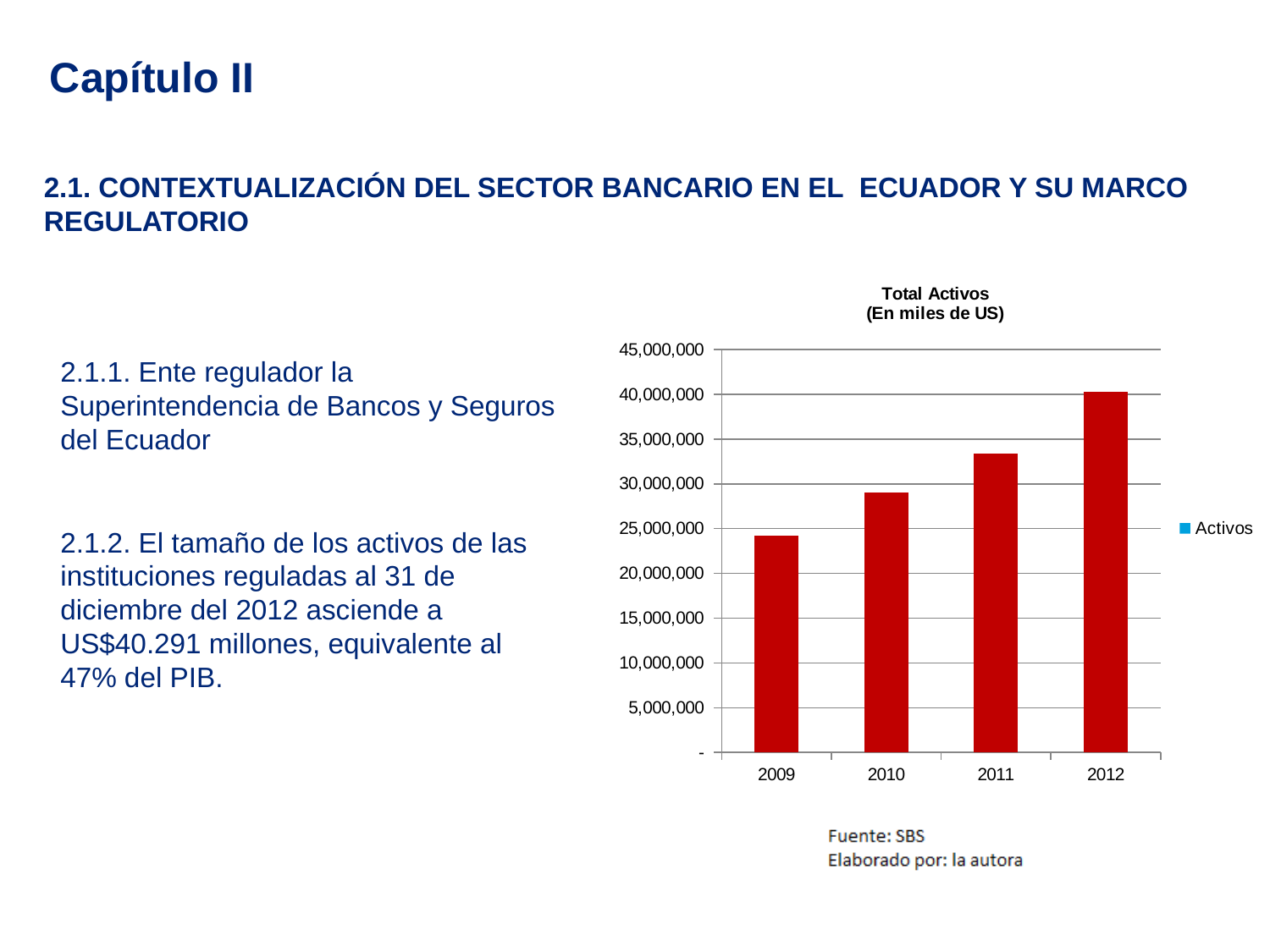
Do the values for Activos rise or fall from 2009 to 2012? rise What type of chart is shown on the slide? bar chart Which year has the lowest value for Activos? 2009 How many series does the chart legend list? 1 How many years are shown on the x axis of the chart? 4 Which year has the larger value for Activos, 2010 or 2011? 2011 Is the value for 2009 greater or less than 25,000,000? less What is the name of the series shown in the legend? Activos Which year has the highest value for Activos? 2012 Is the value for 2012 greater or less than 40,000,000? greater Is the value for 2011 greater or less than 30,000,000? greater What is the title of the chart? Total Activos (En miles de US)